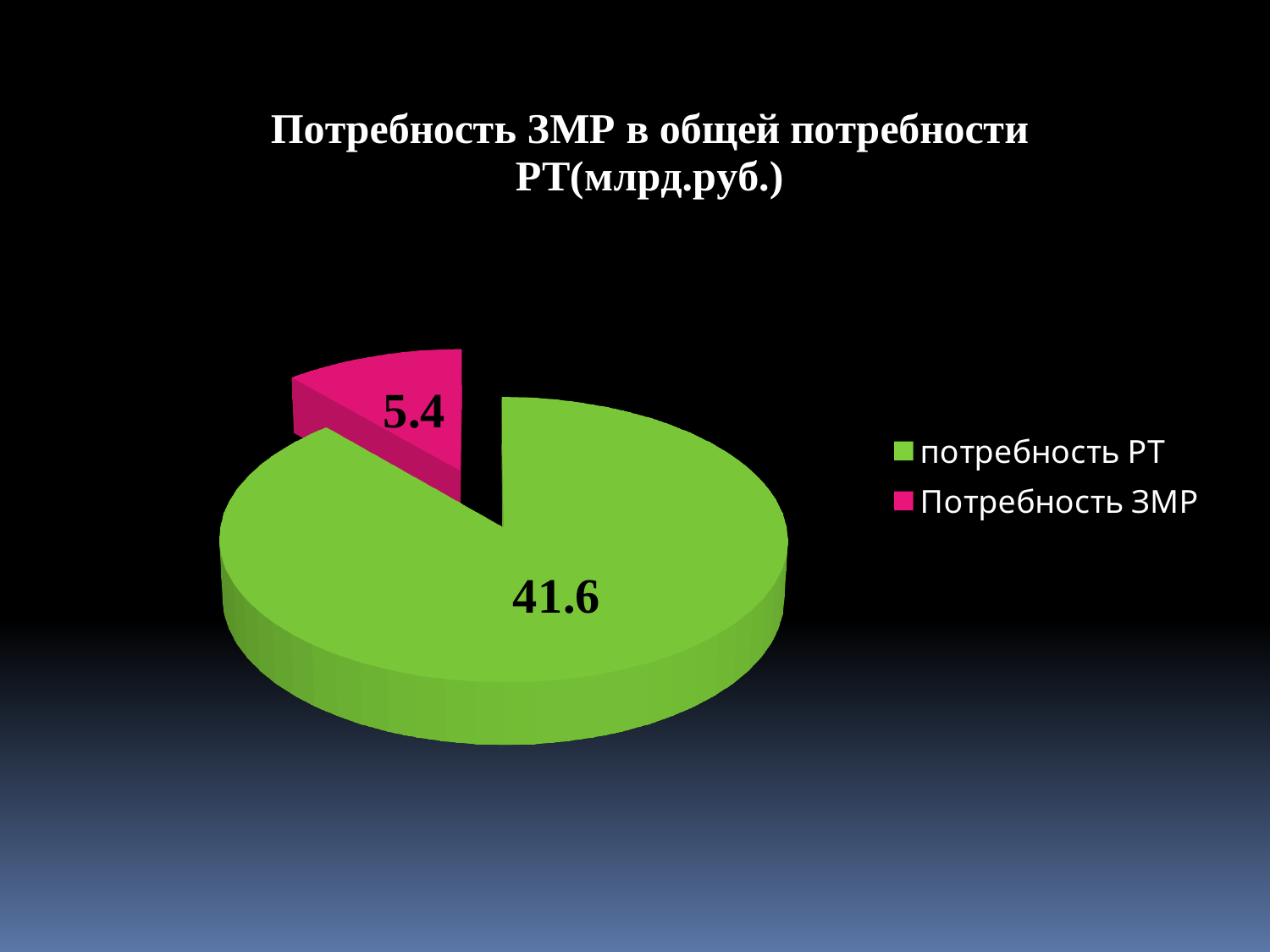
What is the difference between потребность РТ and Потребность ЗМР? 36.2 What is the value for потребность РТ? 41.6 Which slice is the largest? потребность РТ What is the value for Потребность ЗМР? 5.4 How many slices does the pie chart have? 2 What type of chart is shown on the slide? pie chart What is the title of the chart? Потребность ЗМР в общей потребности РТ(млрд.руб.) What colour is the Потребность ЗМР slice? pink Which is larger, потребность РТ or Потребность ЗМР? потребность РТ What is the total of the two slices? 47 Which slice is the smallest? Потребность ЗМР How many entries does the legend list? 2